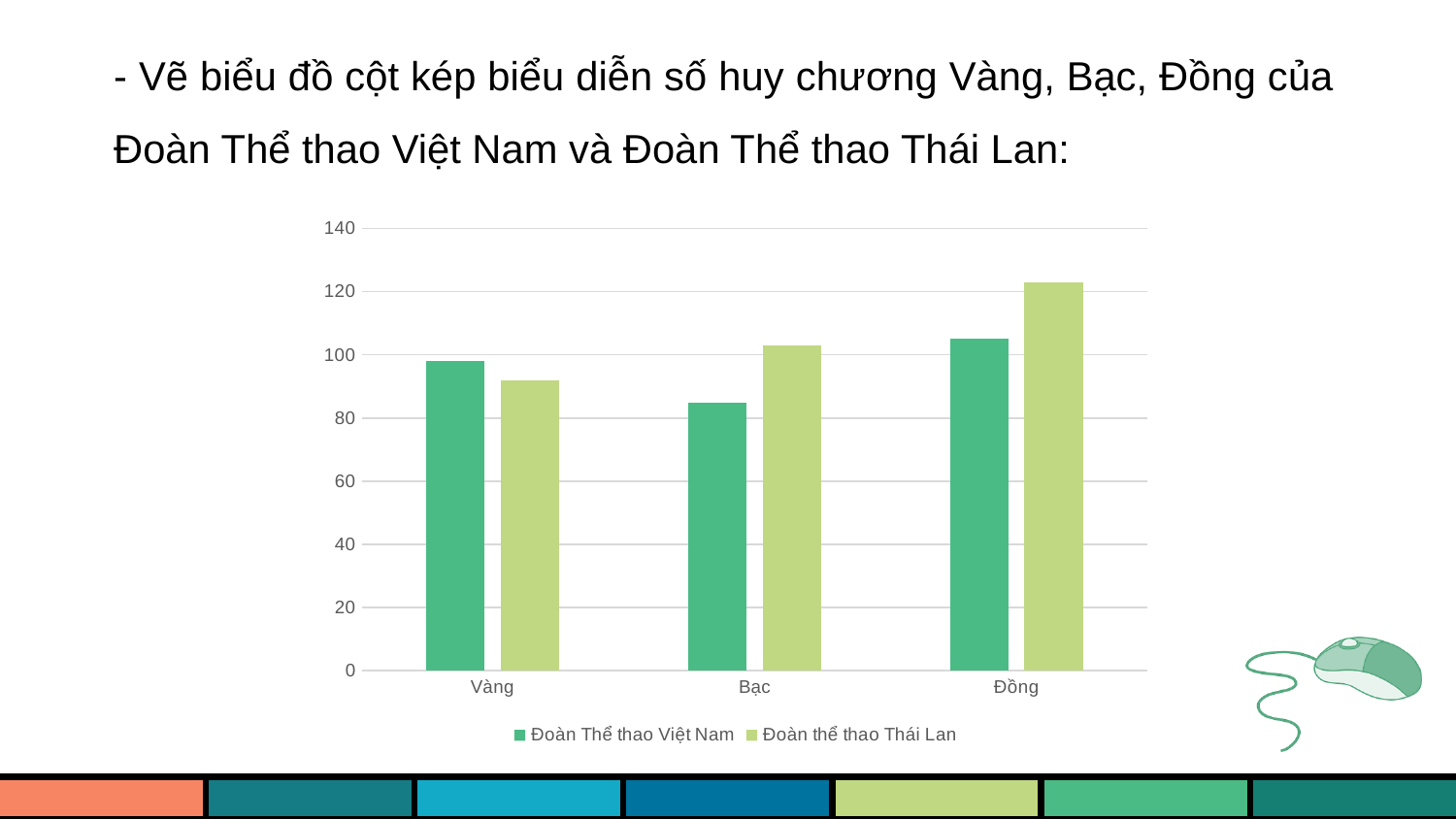
How many series does the legend list? 2 Is the value for Đoàn Thể thao Việt Nam at Bạc greater or less than 80? greater Is the value for Đoàn thể thao Thái Lan at Vàng greater or less than 100? less Which series does the darker green bar represent? Đoàn Thể thao Việt Nam What kind of chart is shown on the slide? bar chart For which category is the value for Đoàn thể thao Thái Lan highest? Đồng For which category is the value for Đoàn thể thao Thái Lan lowest? Vàng For Bạc, which is larger: Đoàn Thể thao Việt Nam or Đoàn thể thao Thái Lan? Đoàn thể thao Thái Lan Is the value for Đoàn thể thao Thái Lan at Đồng greater or less than 100? greater For which category is the value for Đoàn Thể thao Việt Nam lowest? Bạc How many categories are shown on the x axis? 3 For Vàng, which is larger: Đoàn Thể thao Việt Nam or Đoàn thể thao Thái Lan? Đoàn Thể thao Việt Nam